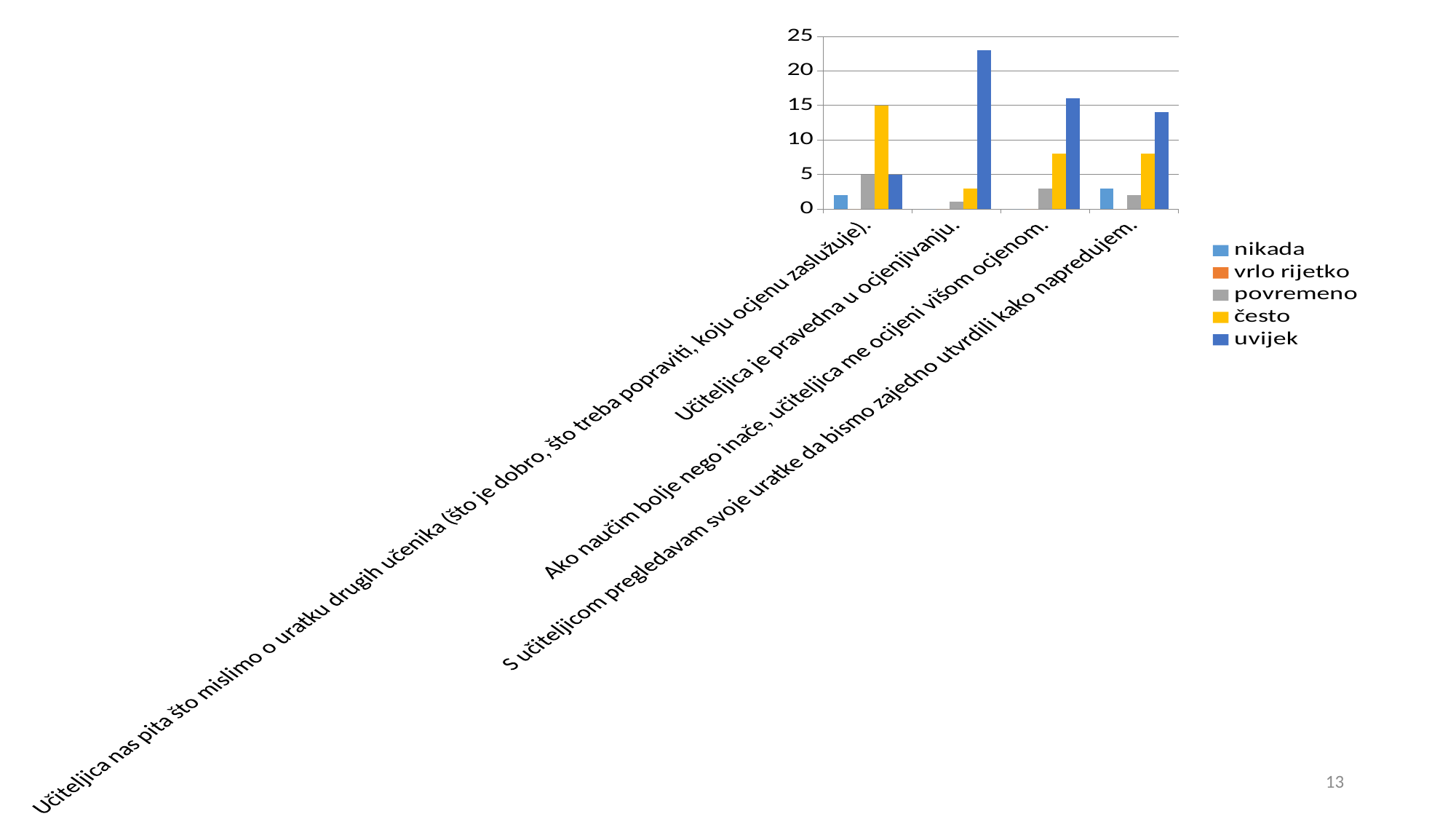
Which category has the highest 'uvijek' value? Učiteljica je pravedna u ocjenjivanju. Which legend entry is shown in yellow? često What kind of chart is shown on the slide? bar chart Is the value of 'često' for 'Ako naučim bolje nego inače, učiteljica me ocijeni višom ocjenom.' greater or less than 10? less What is the value of 'povremeno' for 'Učiteljica nas pita što mislimo o uratku drugih učenika (što je dobro, što treba popraviti, koju ocjenu zaslužuje).'? 5 Is the value of 'uvijek' for 'Učiteljica je pravedna u ocjenjivanju.' greater or less than 20? greater What is the value of 'često' for 'Učiteljica nas pita što mislimo o uratku drugih učenika (što je dobro, što treba popraviti, koju ocjenu zaslužuje).'? 15 How many categories are shown on the x axis? 4 Which series is the only one with a value above 20 anywhere in the chart? uvijek Is the value of 'uvijek' for 'S učiteljicom pregledavam svoje uratke da bismo zajedno utvrdili kako napredujem.' greater or less than 10? greater Which is larger for 'Učiteljica nas pita što mislimo o uratku drugih učenika (što je dobro, što treba popraviti, koju ocjenu zaslužuje).': 'često' or 'uvijek'? često How many series does the legend list? 5